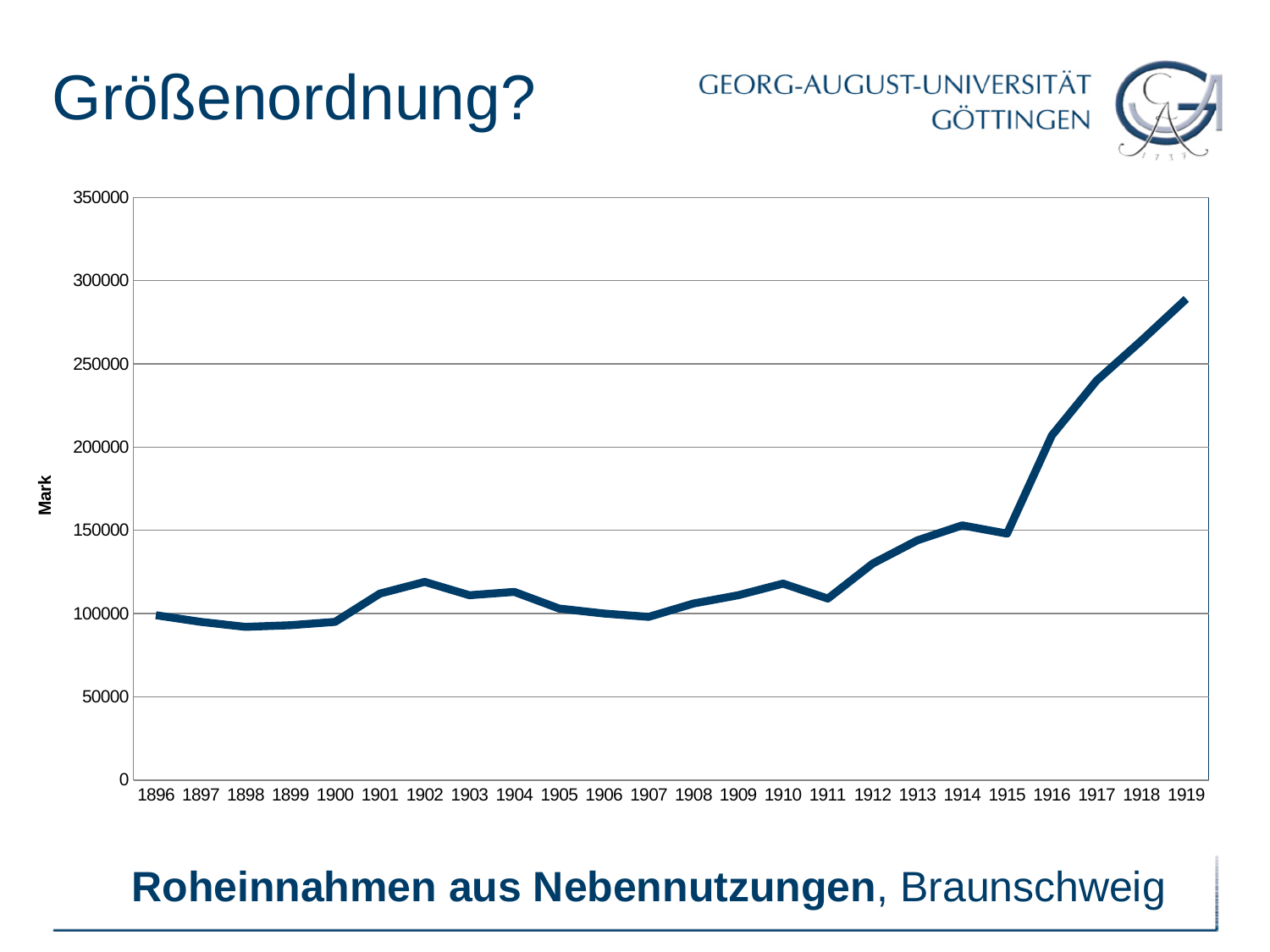
How many years are plotted along the x axis of the chart? 24 What kind of chart is shown on the slide? line chart What is the label of the y axis? Mark Is the value for 1912 greater or less than 100000? greater Which year has the larger value, 1915 or 1916? 1916 What is the title shown below the chart? Roheinnahmen aus Nebennutzungen, Braunschweig Is the value for 1919 greater or less than 250000? greater Is the value for 1898 greater or less than 100000? less Does the line rise or fall between 1915 and 1919? rise Which year has the highest value in the chart? 1919 Which year has the larger value, 1896 or 1919? 1919